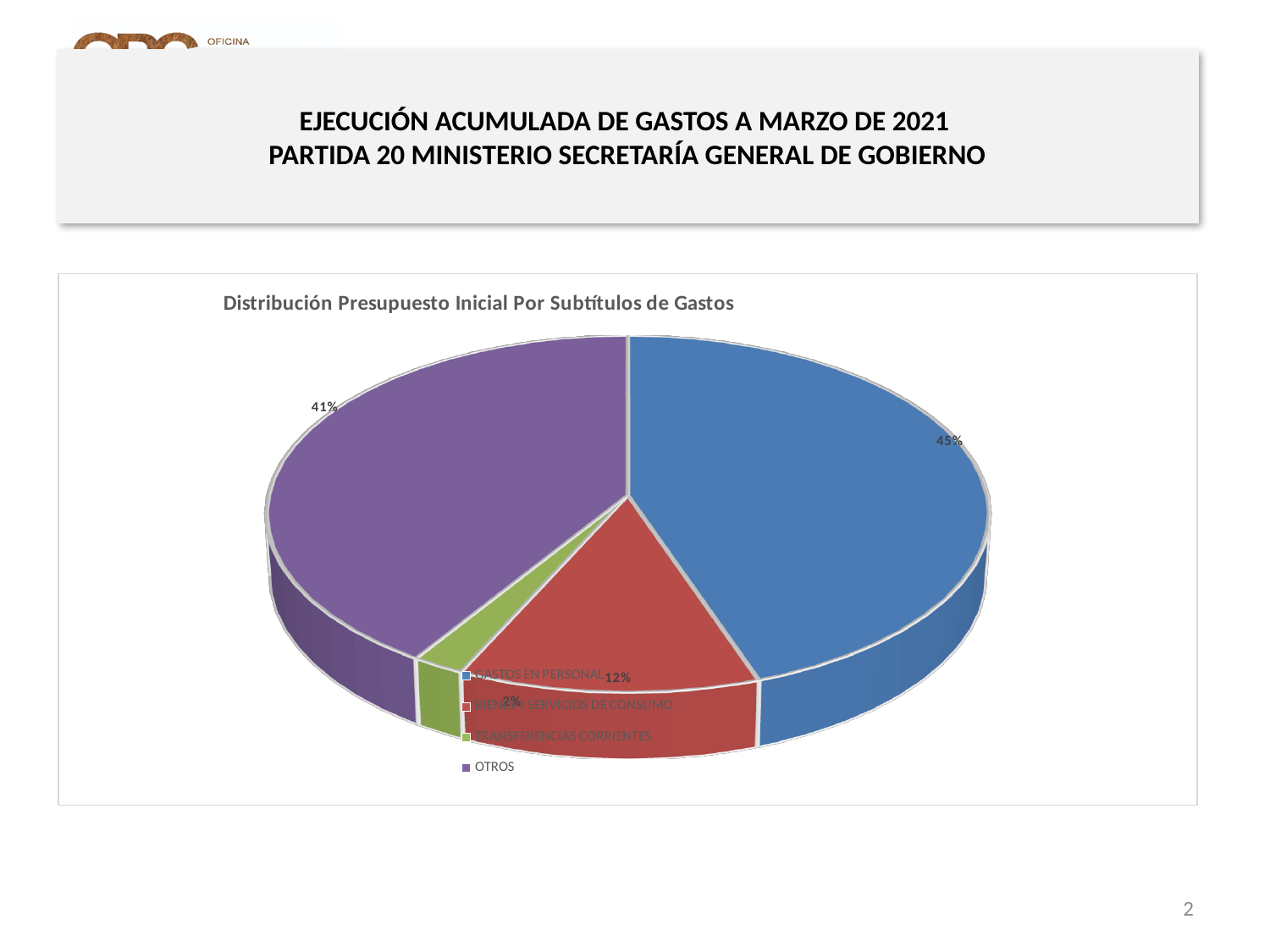
What share of the pie does BIENES Y SERVICIOS DE CONSUMO represent? 12% What colour is the slice for OTROS? Purple What is the difference in percentage points between GASTOS EN PERSONAL and OTROS? 4 percentage points What is the chart's title? Distribución Presupuesto Inicial Por Subtítulos de Gastos Which category has the largest slice of the pie? GASTOS EN PERSONAL What share of the pie does OTROS represent? 41% What kind of chart is shown on the slide? Pie chart Which is larger, the share for BIENES Y SERVICIOS DE CONSUMO or the share for TRANSFERENCIAS CORRIENTES? BIENES Y SERVICIOS DE CONSUMO What share of the pie does TRANSFERENCIAS CORRIENTES represent? 2% How many categories does the legend list? 4 Which category has the smallest slice of the pie? TRANSFERENCIAS CORRIENTES